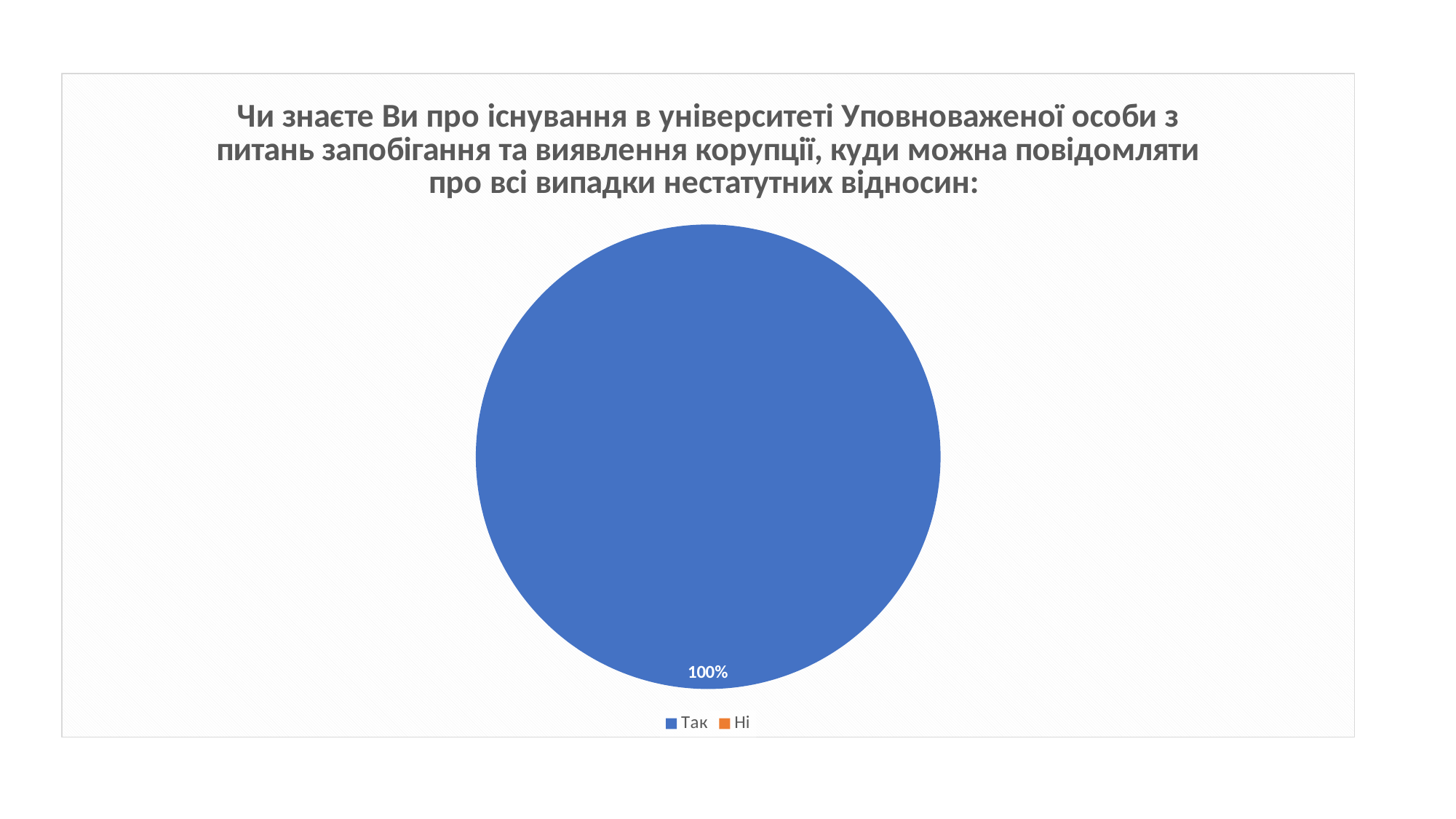
What colour is the "Так" slice of the pie chart? blue How many entries does the legend list? 2 What colour does the legend assign to "Ні"? orange What is the data label shown on the "Так" slice? 100% Which category has the largest share of the pie? Так Which category has the smallest share of the pie? Ні Which is larger, the share for "Так" or the share for "Ні"? Так What share of the pie does the "Так" slice represent? 100% How many categories are listed in the legend of the pie chart? 2 What kind of chart is shown on the slide? pie chart